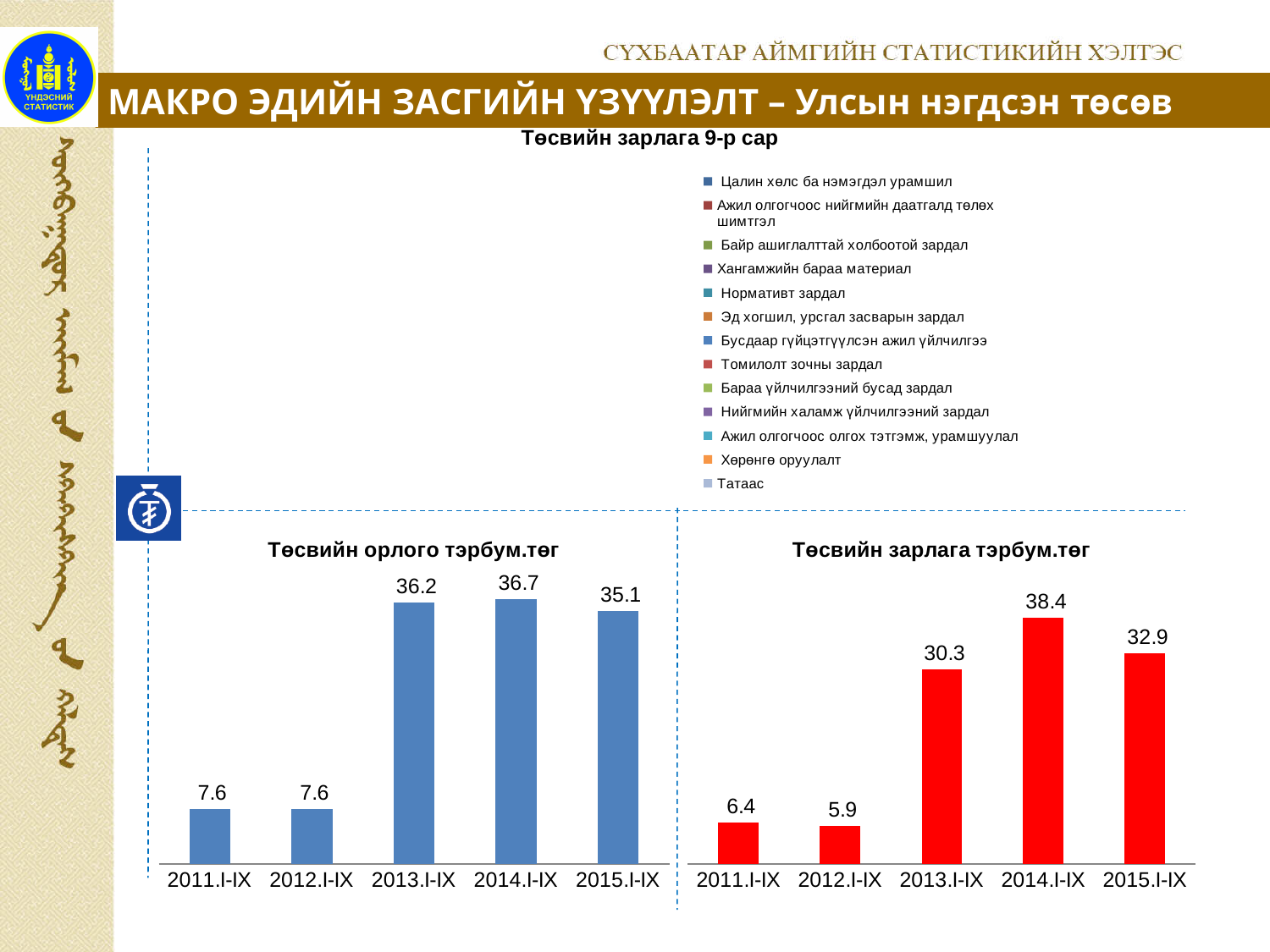
In the chart titled "Төсвийн орлого тэрбум.төг", which period has the highest value? 2014.I-IX In the chart titled "Төсвийн зарлага тэрбум.төг", which period has the highest value? 2014.I-IX What colour are the bars in the chart titled "Төсвийн зарлага тэрбум.төг"? Red In the chart titled "Төсвийн зарлага тэрбум.төг", which period has the lowest value? 2012.I-IX In the chart titled "Төсвийн зарлага тэрбум.төг", what is the difference between the values for 2014.I-IX and 2013.I-IX? 8.1 How many periods are shown on the x axis of the chart titled "Төсвийн орлого тэрбум.төг"? 5 In the chart titled "Төсвийн орлого тэрбум.төг", what is the value for 2011.I-IX? 7.6 In the chart titled "Төсвийн орлого тэрбум.төг", what is the difference between the values for 2014.I-IX and 2015.I-IX? 1.6 In the chart titled "Төсвийн зарлага тэрбум.төг", which is larger, the value for 2011.I-IX or 2012.I-IX? 2011.I-IX What kind of chart is the chart titled "Төсвийн зарлага тэрбум.төг"? Bar chart In the chart titled "Төсвийн зарлага тэрбум.төг", what is the value for 2015.I-IX? 32.9 In the chart titled "Төсвийн орлого тэрбум.төг", what is the value for 2013.I-IX? 36.2